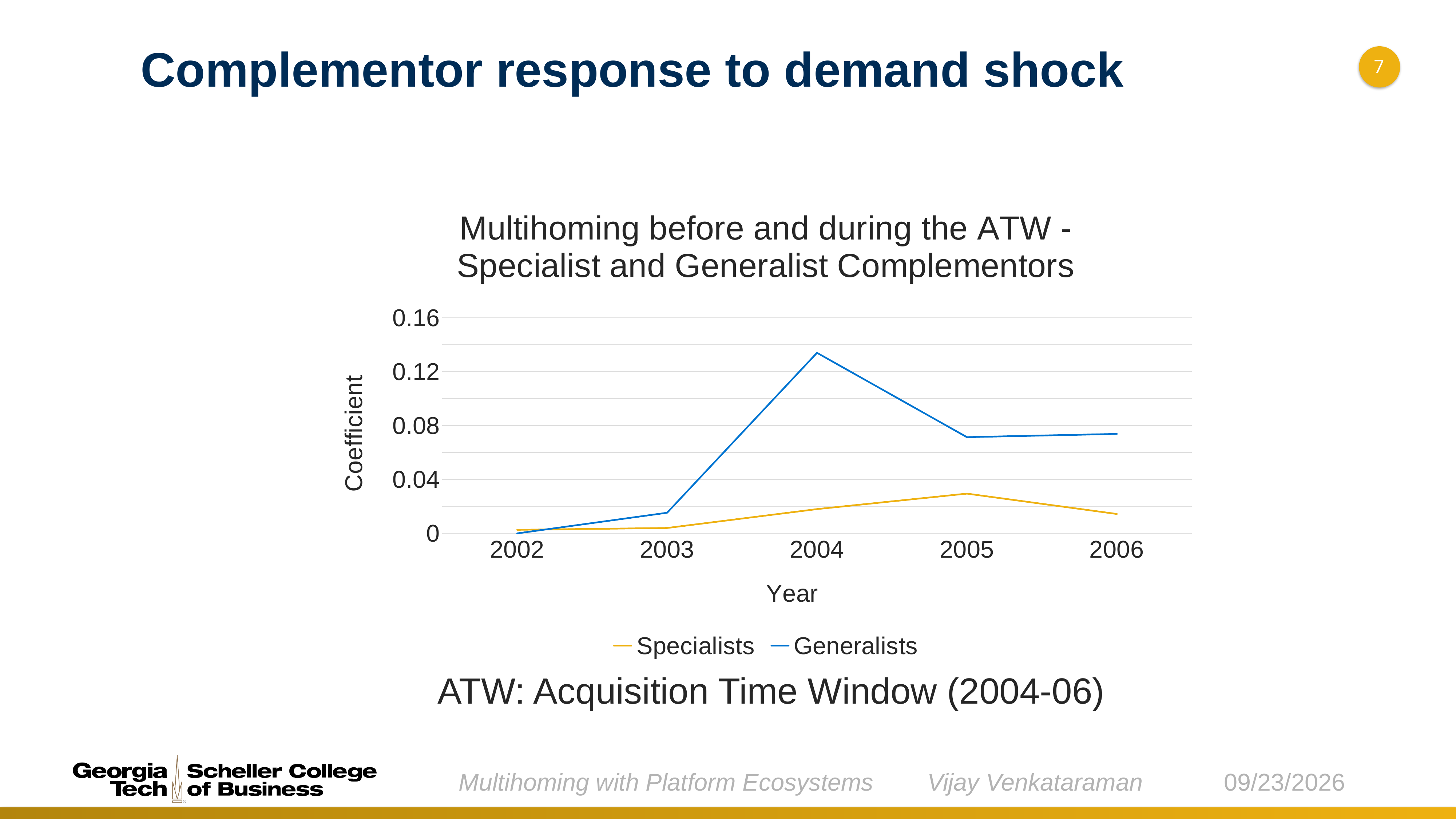
Is the value for Specialists in 2005 greater or less than 0.04? less What is the label of the y axis? Coefficient In which year does the Specialists series reach its highest value? 2005 In which year does the Generalists series reach its highest value? 2004 How many series does the legend list? 2 How many years are plotted along the x axis? 5 What type of chart is shown on the slide? Line chart Is the value for Generalists in 2004 greater or less than 0.12? greater In 2004, which series has the larger value, Specialists or Generalists? Generalists Does the Generalists series rise or fall from 2004 to 2005? Fall Is the value for Generalists in 2005 greater or less than 0.08? less What is the title of the chart? Multihoming before and during the ATW - Specialist and Generalist Complementors